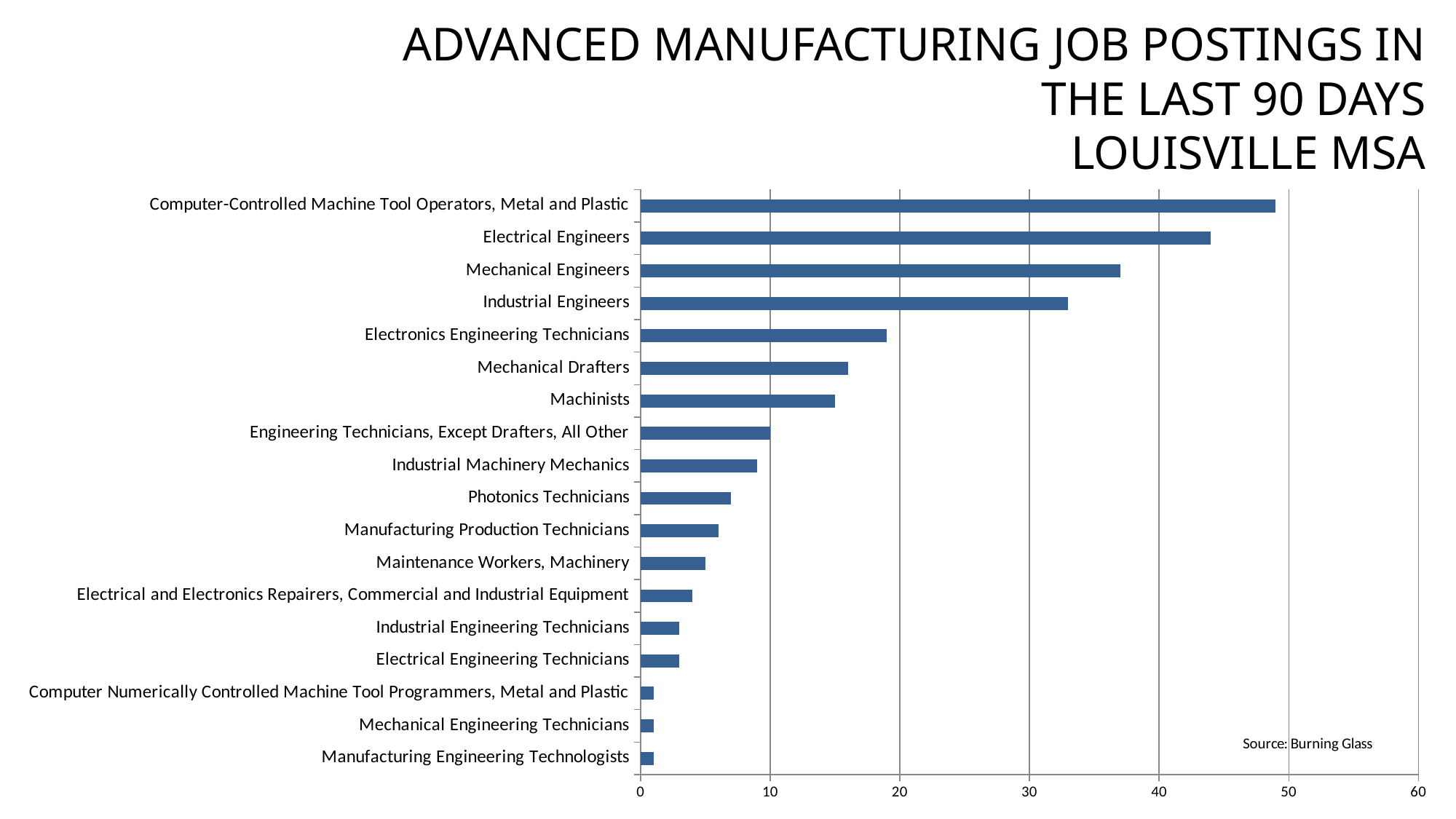
Which has more job postings, Electrical Engineers or Mechanical Engineers? Electrical Engineers Is the value for Electrical Engineers greater or less than 40? greater How many occupations are listed in the chart? 18 Is the value for Machinists greater or less than 10? greater What is the source cited for the chart data? Burning Glass Which has more job postings, Industrial Engineers or Electronics Engineering Technicians? Industrial Engineers Is the value for Electronics Engineering Technicians greater or less than 20? less Which occupation has the highest number of job postings? Computer-Controlled Machine Tool Operators, Metal and Plastic What is the value for Engineering Technicians, Except Drafters, All Other? 10 What kind of chart is shown on the slide? Bar chart